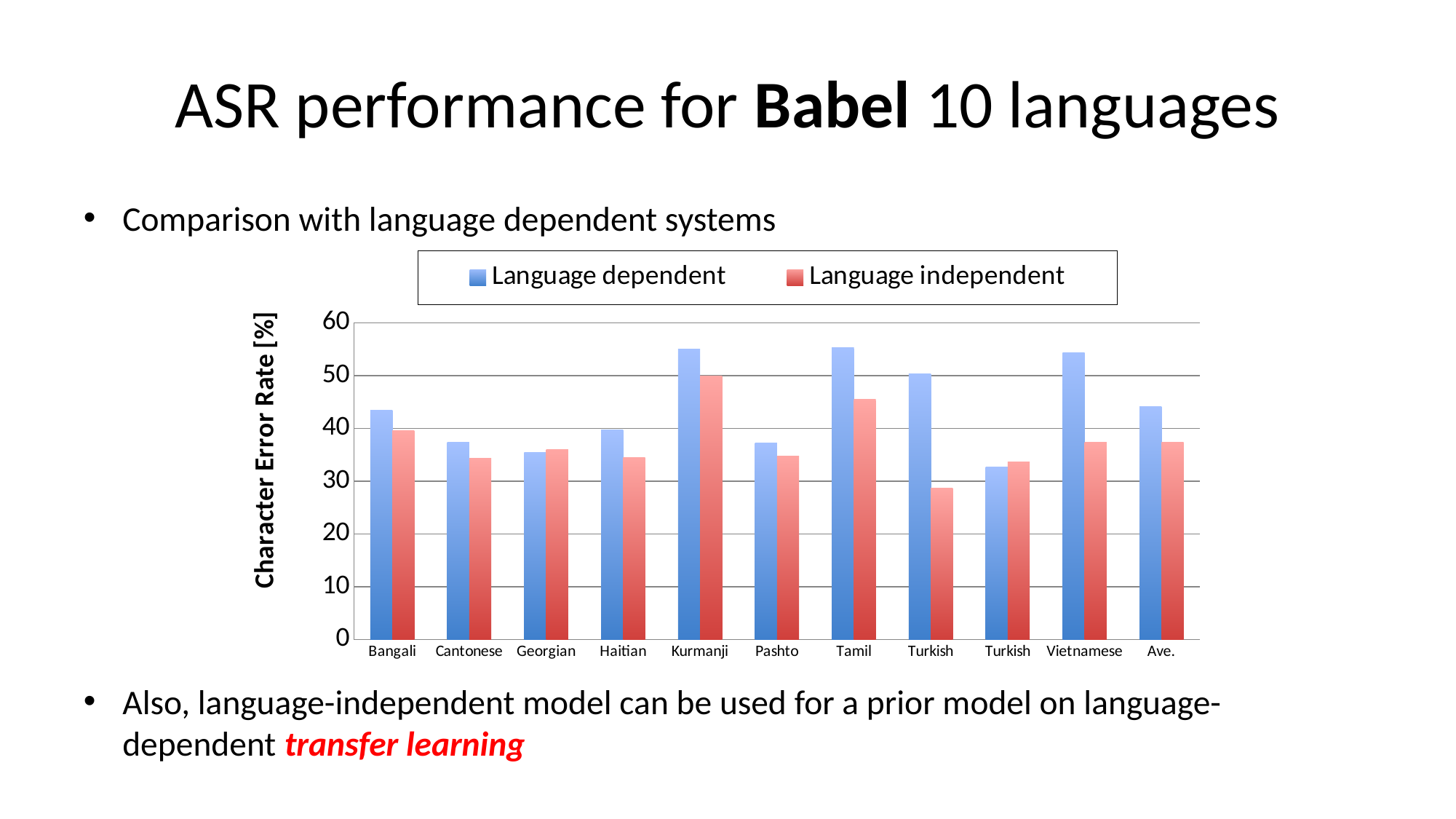
Is the Language independent value for Vietnamese greater or less than 40? less Is the Language independent value for Tamil greater or less than 40? greater What is the label of the vertical axis? Character Error Rate [%] Which category has the highest Language independent value? Kurmanji What kind of chart is shown on the slide? bar chart Is the Language dependent value for Kurmanji greater or less than 50? greater Which is larger: the Language independent value for Kurmanji or the Language independent value for Bangali? Kurmanji Which series is drawn in red? Language independent For Tamil, which is larger: the Language dependent value or the Language independent value? Language dependent How many series does the legend list? 2 How many category groups are shown along the x axis? 11